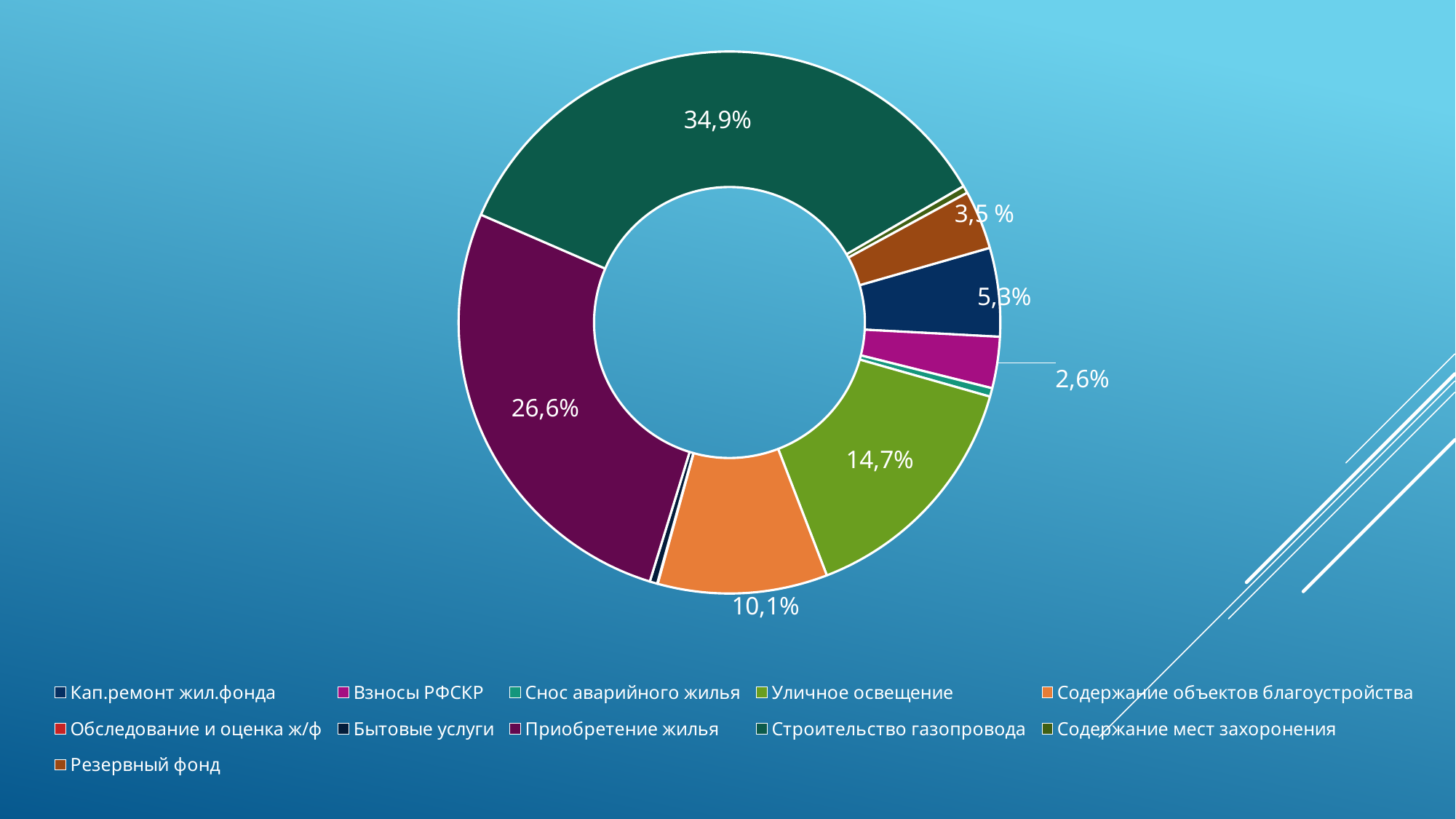
What is the difference in percentage points between Строительство газопровода and Приобретение жилья? 8,3 What share does Приобретение жилья have in the chart? 26,6% What share does Взносы РФСКР have in the chart? 2,6% Which category has the largest share in the chart? Строительство газопровода What share does Уличное освещение have in the chart? 14,7% What is the difference in percentage points between Уличное освещение and Содержание объектов благоустройства? 4,6 How many categories does the legend list? 11 Which has the larger share: Кап.ремонт жил.фонда or Взносы РФСКР? Кап.ремонт жил.фонда What kind of chart is shown on the slide? Doughnut (pie) chart What share does Строительство газопровода have in the chart? 34,9% What share does Содержание объектов благоустройства have in the chart? 10,1% What share does Кап.ремонт жил.фонда have in the chart? 5,3%